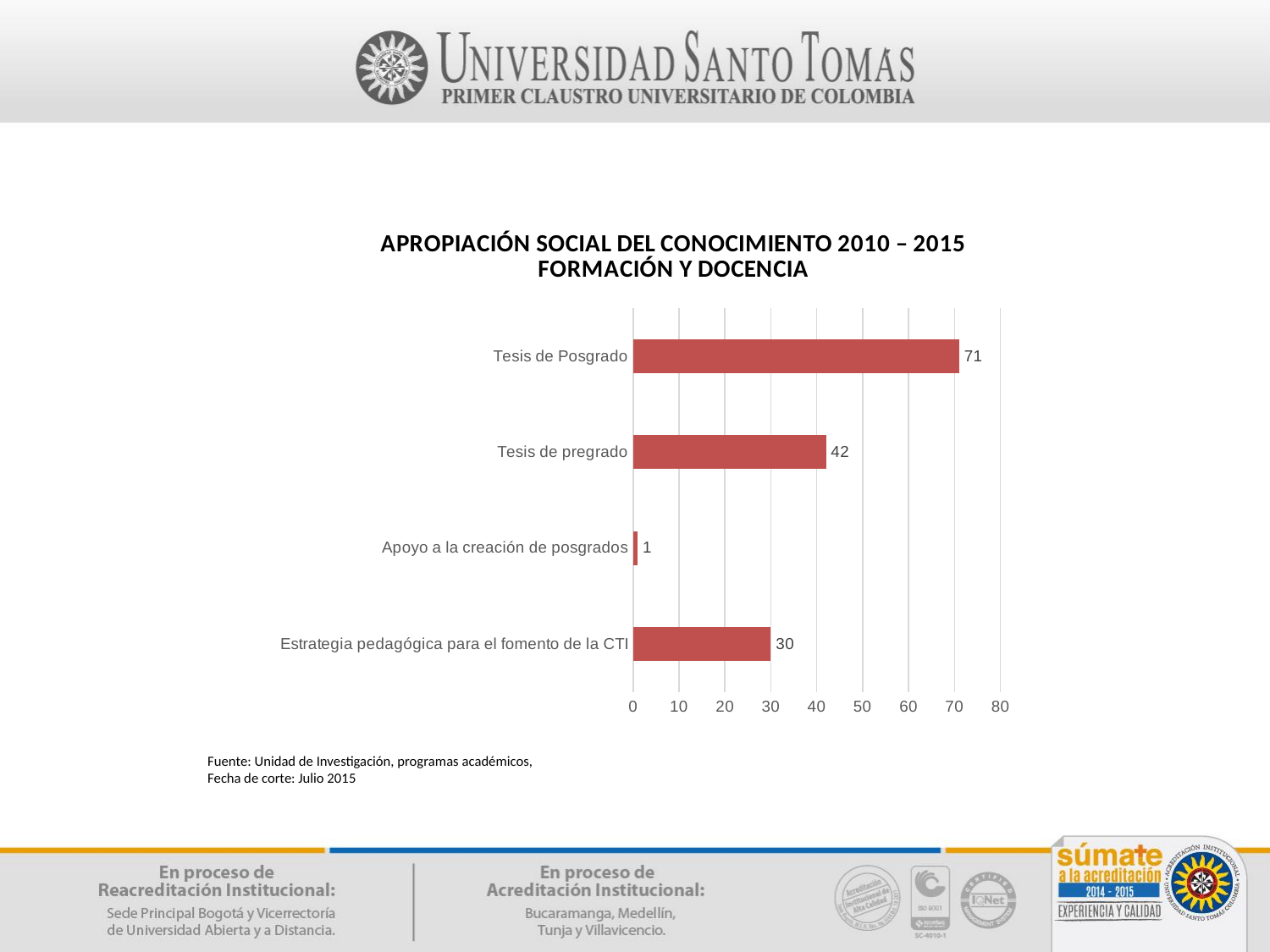
Which category has the highest value? Tesis de Posgrado Which category has the lowest value? Apoyo a la creación de posgrados Is the value for Tesis de Posgrado greater or less than 60? greater What is the difference between the values for Tesis de Posgrado and Tesis de pregrado? 29 How many categories are shown in the chart? 4 What is the value for Tesis de pregrado? 42 What is the difference between the values for Tesis de pregrado and Estrategia pedagógica para el fomento de la CTI? 12 Which is larger, the value for Tesis de pregrado or the value for Estrategia pedagógica para el fomento de la CTI? Tesis de pregrado What kind of chart is shown on the slide? Bar chart What is the value for Tesis de Posgrado? 71 What is the value for Estrategia pedagógica para el fomento de la CTI? 30 What is the value for Apoyo a la creación de posgrados? 1